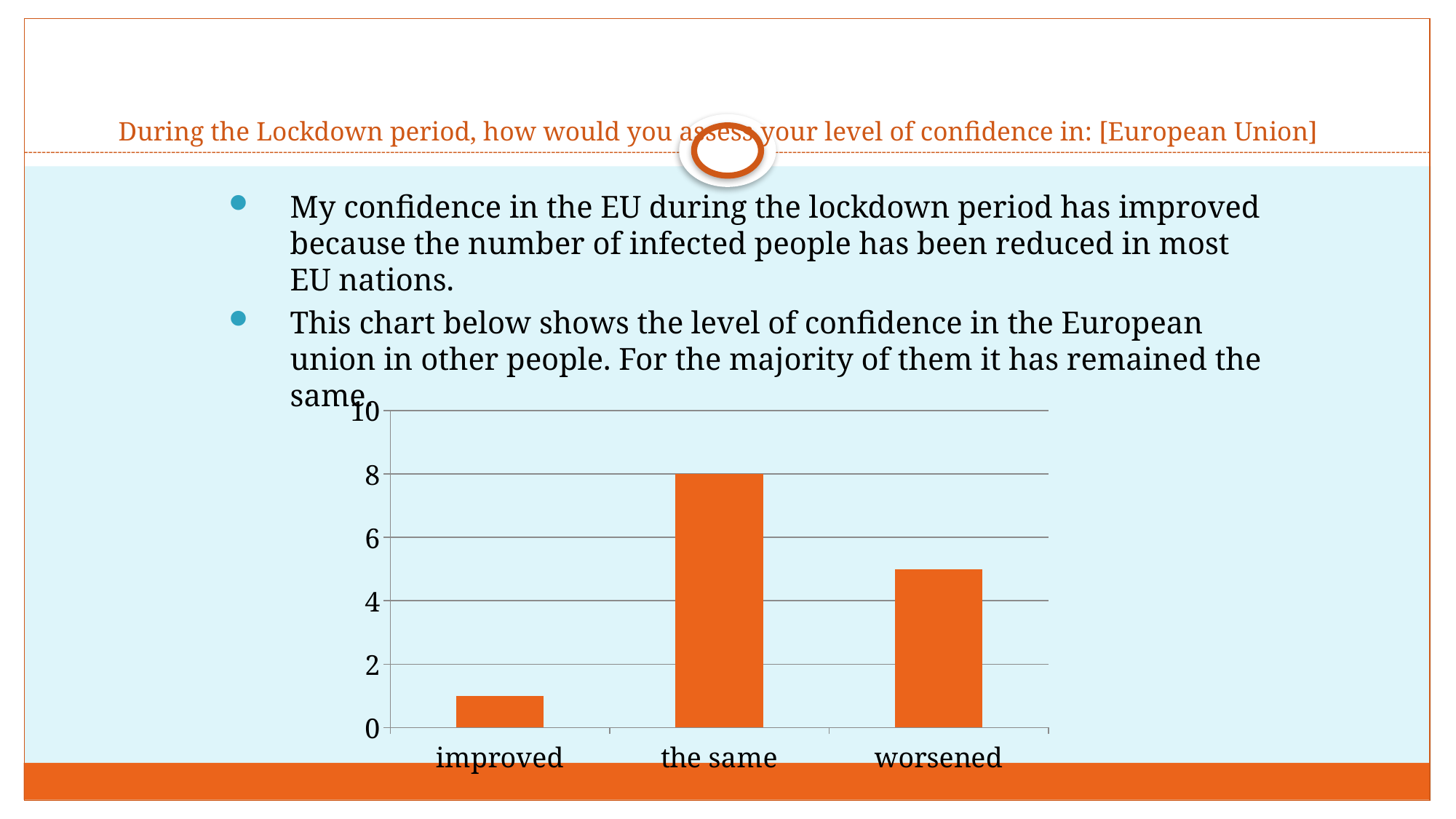
Which category has the highest bar in the chart? the same What type of chart is shown on the slide? bar chart Is the value for "worsened" greater or less than 4? greater Which is larger, the value for "the same" or the value for "worsened"? the same What colour are the bars in the chart? orange Which category has the lowest bar in the chart? improved Is the value for "worsened" greater or less than 6? less What is the highest value shown on the y axis of the chart? 10 Which is larger, the value for "worsened" or the value for "improved"? worsened Is the value for "improved" greater or less than 2? less What is the value for "the same" in the chart? 8 How many categories are shown on the x axis of the chart? 3